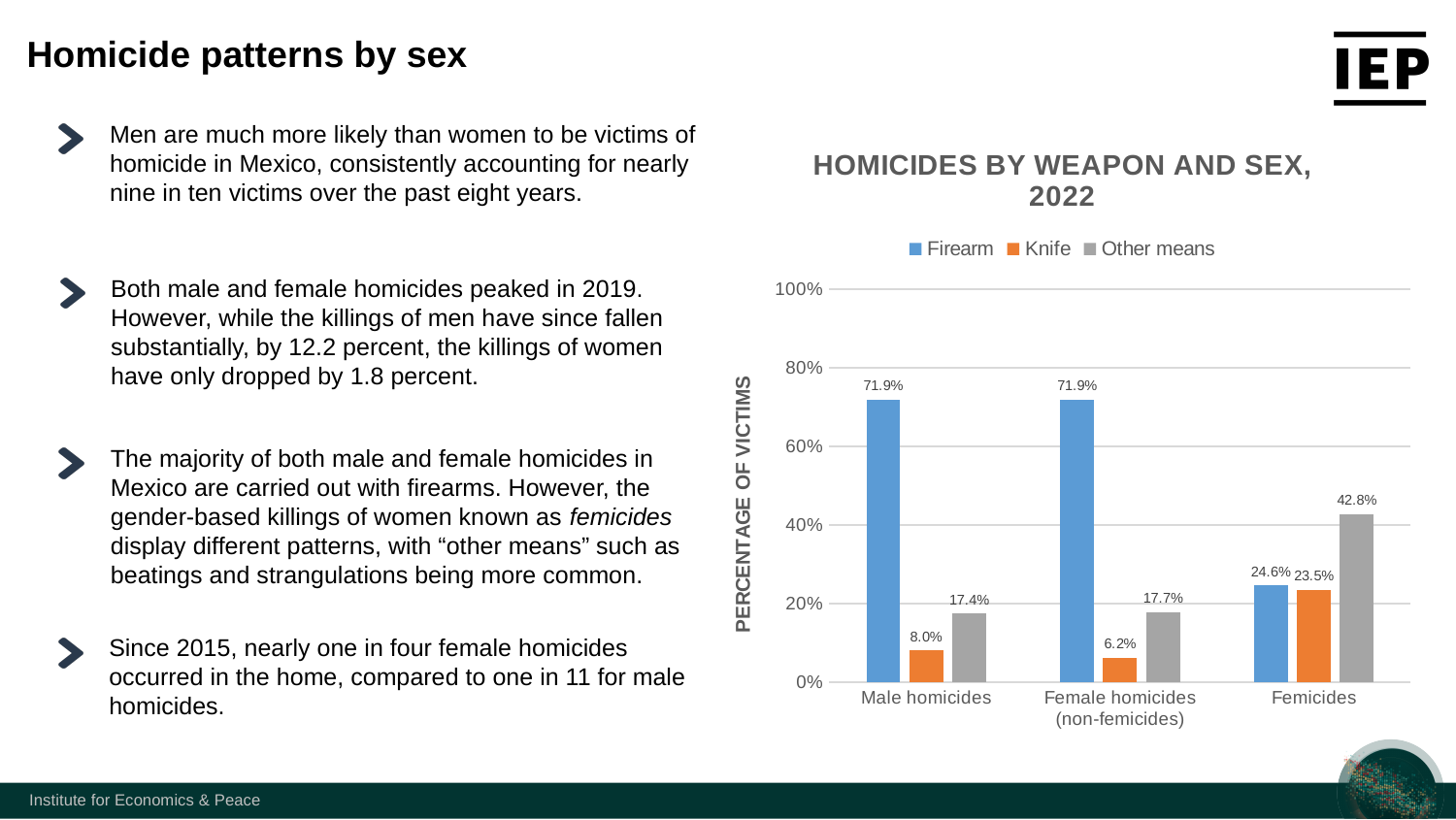
Which weapon type has the highest share among femicides? Other means What is the Knife value for Female homicides (non-femicides)? 6.2% How many series does the legend list? 3 Which is larger: the Knife share for Male homicides or for Female homicides (non-femicides)? Male homicides Is the Firearm value for Femicides greater or less than 40%? less What is the value for Knife in the Femicides category? 23.5% Which weapon type has the lowest share among male homicides? Knife What is the difference between the Other means share for Femicides and for Male homicides? 25.4% What percentage of male homicides were committed with a firearm? 71.9% What percentage of femicides were committed by other means? 42.8% How many categories are shown on the x axis? 3 What type of chart is shown on the slide? Bar chart